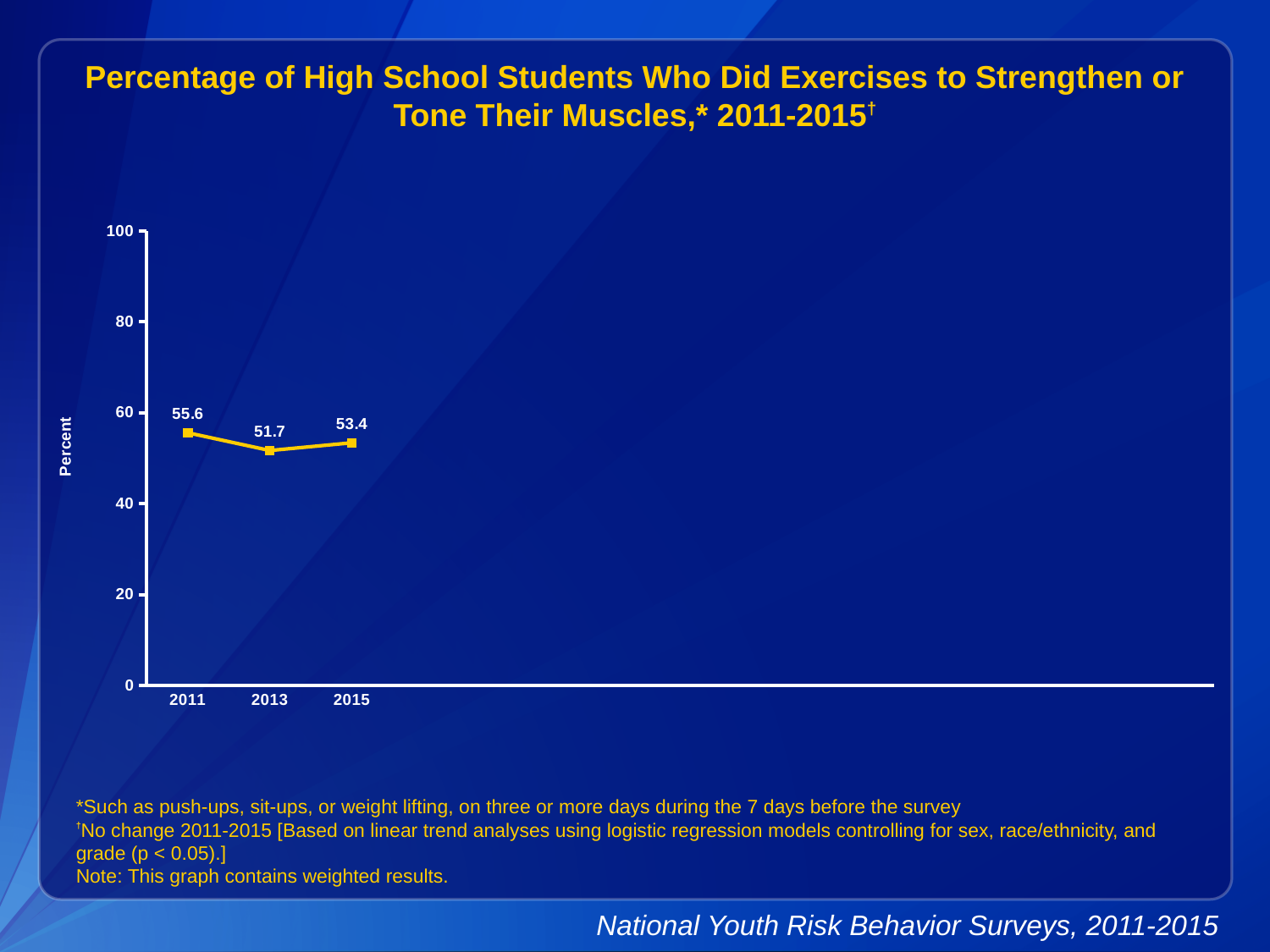
Is the value for 2013 greater or less than 60? less What was the percentage of high school students who did exercises to strengthen or tone their muscles in 2011? 55.6 How many years are plotted on the chart? 3 Which year had the highest percentage of students who did muscle-strengthening exercises? 2011 What is the difference between the 2015 and 2013 percentages? 1.7 What was the percentage of high school students who did exercises to strengthen or tone their muscles in 2013? 51.7 Which year had the lowest percentage of students who did muscle-strengthening exercises? 2013 What was the percentage of high school students who did exercises to strengthen or tone their muscles in 2015? 53.4 What kind of chart is shown on the slide? line chart Which year had a higher percentage, 2011 or 2015? 2011 What is the difference between the 2011 and 2013 percentages? 3.9 What is the label on the y axis of the chart? Percent